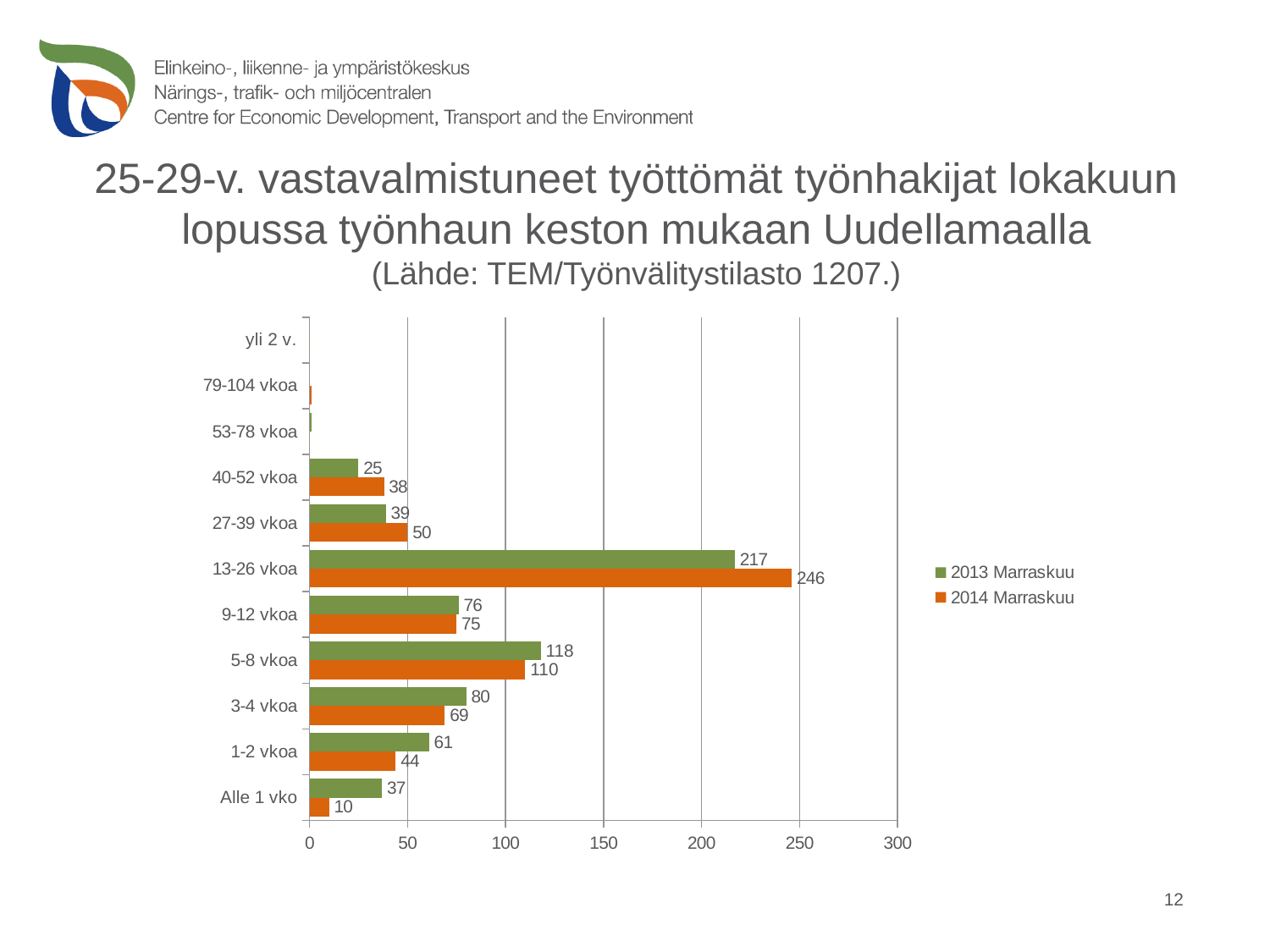
What is the difference between the 2014 Marraskuu and 2013 Marraskuu values for 13-26 vkoa? 29 What is the value for Alle 1 vko in the 2014 Marraskuu series? 10 What is the value for 13-26 vkoa in the 2014 Marraskuu series? 246 Which category has the highest value in the 2013 Marraskuu series? 13-26 vkoa Which is larger for 27-39 vkoa: the 2013 Marraskuu value or the 2014 Marraskuu value? 2014 Marraskuu How many series does the legend list? 2 What kind of chart is shown on the slide? Bar chart What is the difference between the 2013 Marraskuu and 2014 Marraskuu values for Alle 1 vko? 27 Which is larger for 3-4 vkoa: the 2013 Marraskuu value or the 2014 Marraskuu value? 2013 Marraskuu What is the value for 5-8 vkoa in the 2013 Marraskuu series? 118 How many categories are shown on the vertical axis of the chart? 11 Is the 2013 Marraskuu value for 1-2 vkoa greater or less than 50? greater